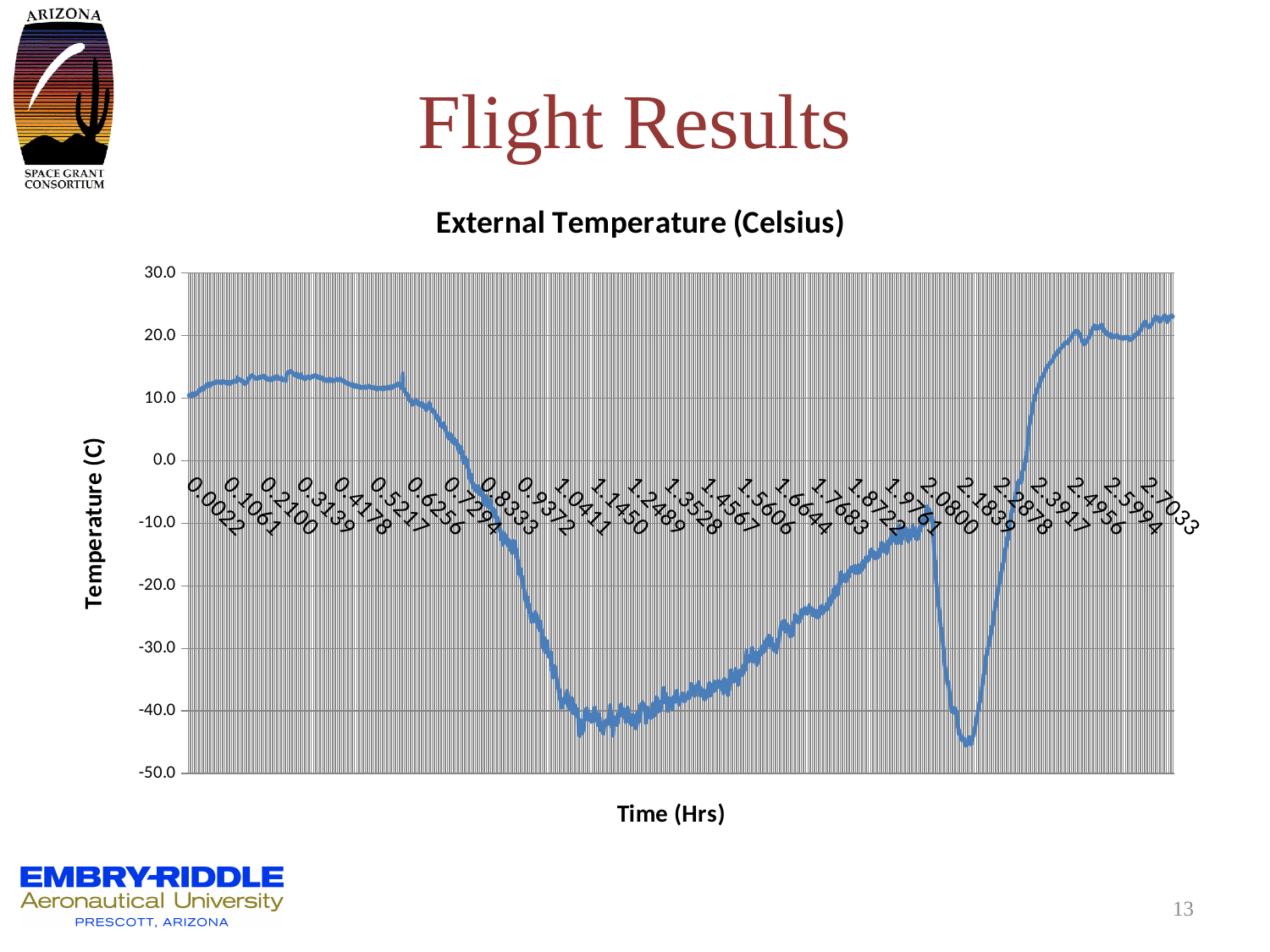
Does the temperature rise or fall between time 0.6256 and time 1.0411? fall Does the temperature rise or fall between time 1.1450 and time 1.9761? rise Which is higher, the temperature at time 0.2100 or at time 1.1450? 0.2100 What is the title of the chart? External Temperature (Celsius) What is the label of the x axis of the chart? Time (Hrs) Is the temperature at time 2.7033 greater or less than 20.0? greater Is the temperature at time 0.2100 greater or less than 10.0? greater Is the temperature at time 1.4567 greater or less than -30.0? less What kind of chart is shown on the slide? line chart